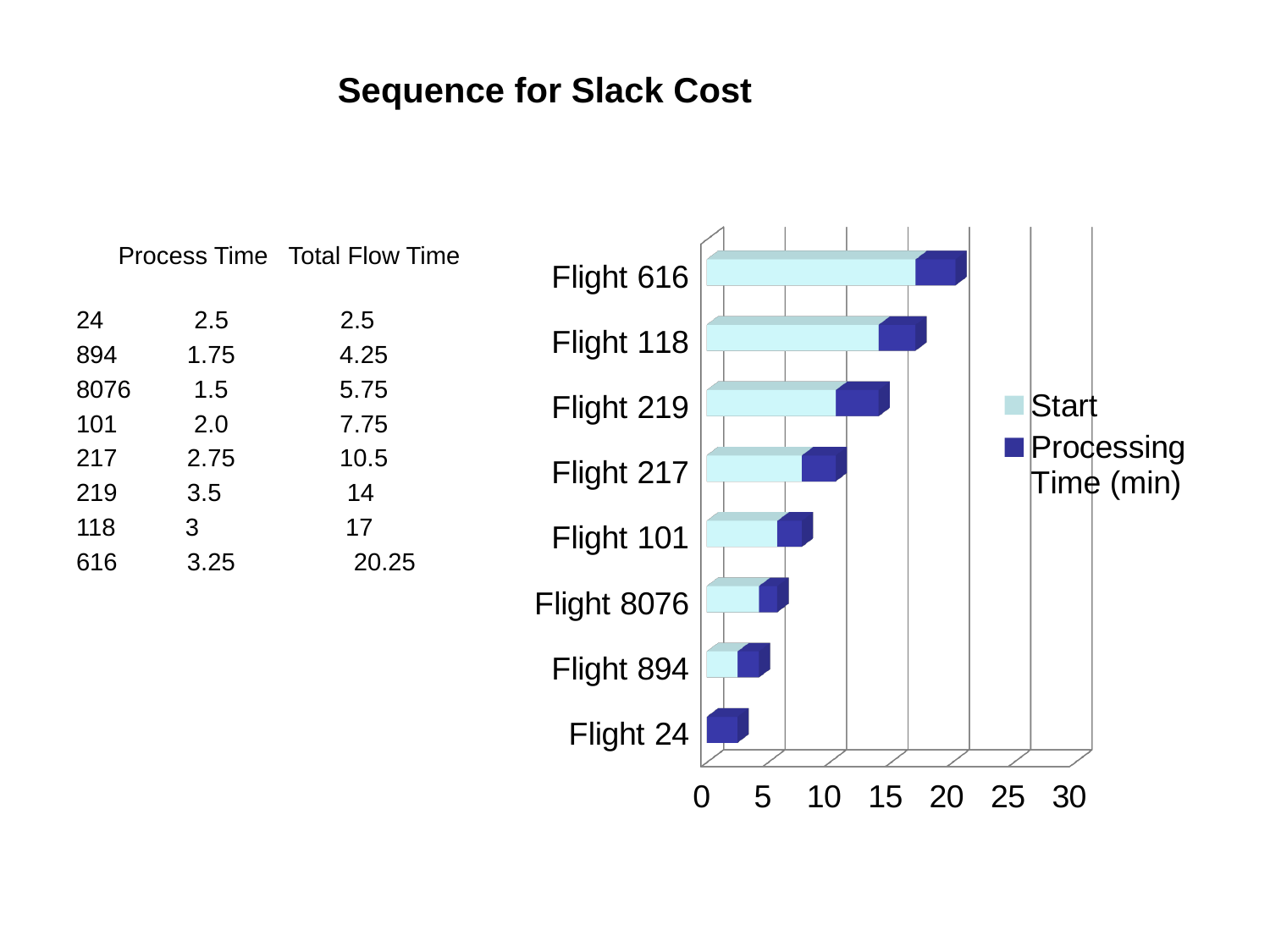
What kind of chart is shown on the slide? bar chart Which has the longer total bar, Flight 118 or Flight 219? Flight 118 What are the two series named in the chart legend? Start and Processing Time (min) Is the total bar length for Flight 894 greater or less than 5? less Which flight has the shortest total bar in the chart? Flight 24 Going from Flight 24 at the bottom to Flight 616 at the top, do the total bars get longer or shorter? longer Which flight has the longest total bar in the chart? Flight 616 Is the total bar length for Flight 101 greater or less than 10? less How many flights are plotted in the chart? 8 Is the total bar length for Flight 118 greater or less than 20? less How many series does the chart legend list? 2